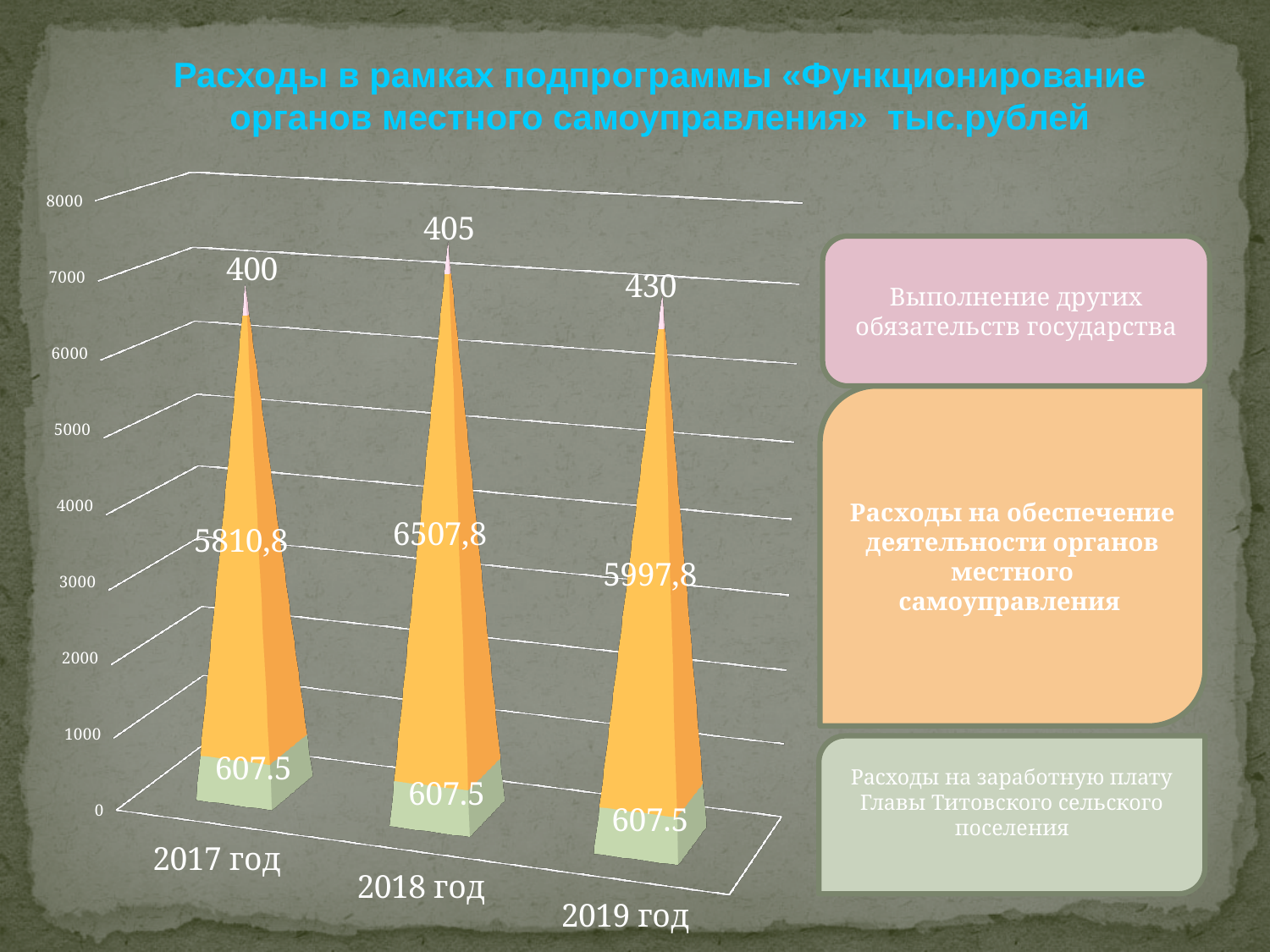
What is the difference between the 2018 and 2017 values for 'Расходы на обеспечение деятельности органов местного самоуправления'? 697 What is the value for 'Выполнение других обязательств государства' in 2019 год? 430 What is the value for 'Расходы на заработную плату Главы Титовского сельского поселения' in 2017 год? 607.5 Which is larger: 'Расходы на обеспечение деятельности органов местного самоуправления' in 2019 год or in 2017 год? 2019 год What is the value for 'Расходы на обеспечение деятельности органов местного самоуправления' in 2019 год? 5997,8 What is the difference between the 2019 and 2017 values for 'Выполнение других обязательств государства'? 30 How many years are shown on the x axis? 3 In which year is 'Расходы на обеспечение деятельности органов местного самоуправления' the highest? 2018 год How many series does the chart show? 3 Does 'Выполнение других обязательств государства' rise or fall from 2017 to 2019? rise What is the value for 'Расходы на обеспечение деятельности органов местного самоуправления' in 2018 год? 6507,8 In which year is 'Выполнение других обязательств государства' the lowest? 2017 год